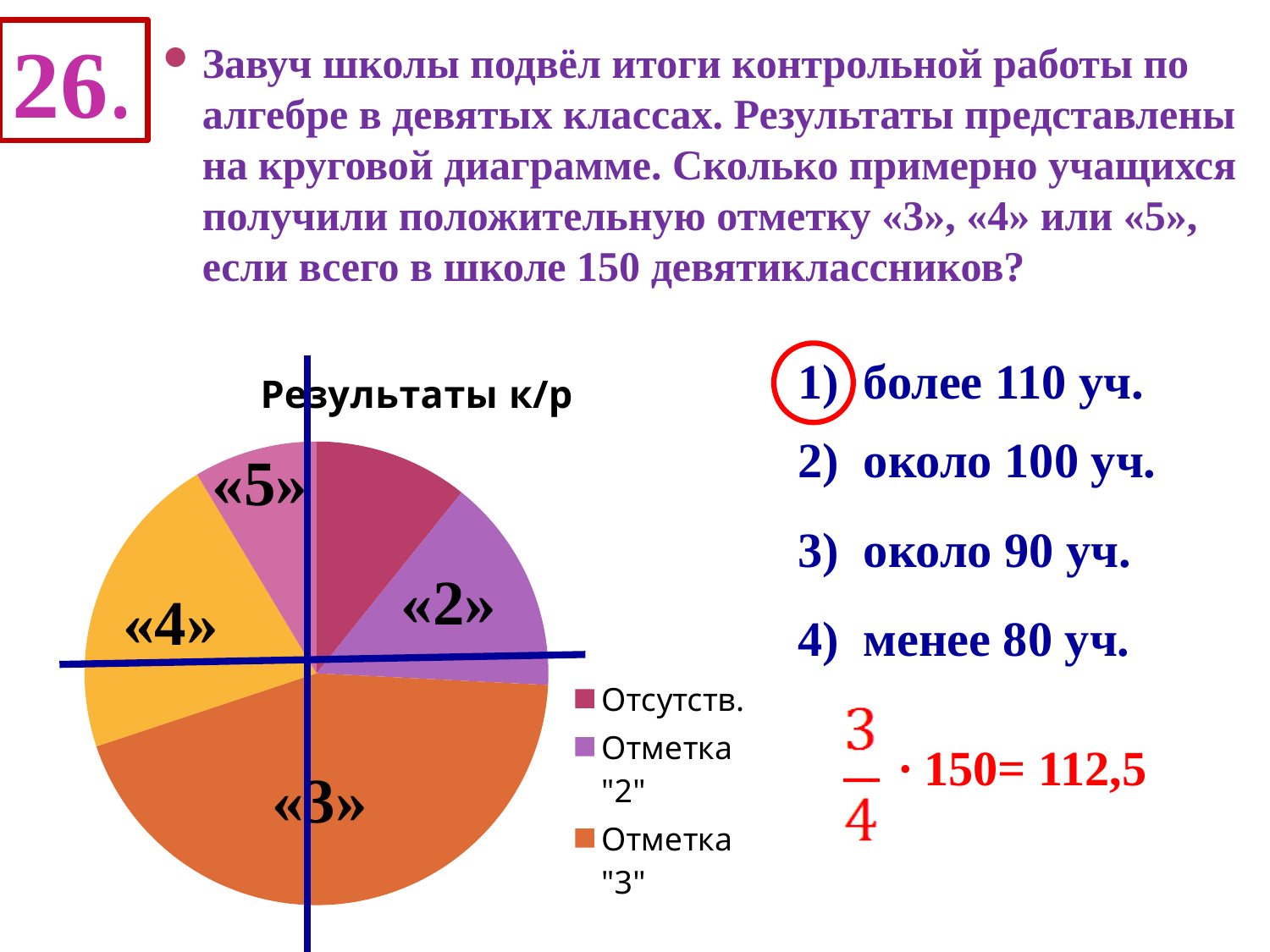
What kind of chart is shown on the slide? pie chart Which slice is larger, «4» or «5»? «4» How many slices does the pie chart have? 5 How many legend entries are visible on the slide? 3 Which slice is larger, «3» or «2»? «3» Which slice is larger, «3» or «4»? «3» Which legend entry corresponds to the dark pink slice at the top of the pie? Отсутств. What colour is the «3» slice of the pie chart? orange What is the title of the pie chart? Результаты к/р Which slice of the pie chart is the largest? «3»